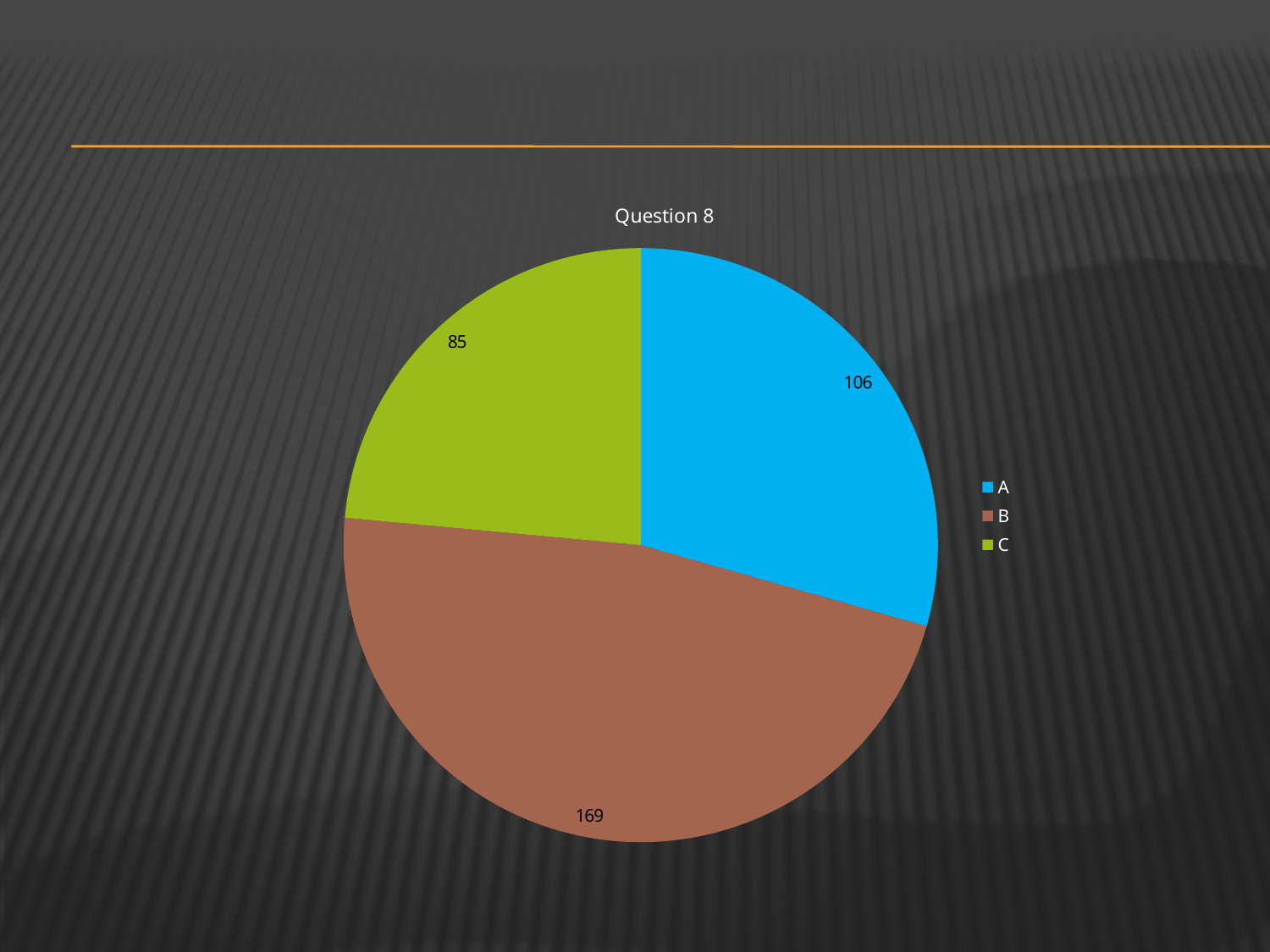
How many categories are shown in the pie chart? 3 What is the value for C in the pie chart? 85 What is the value for B in the pie chart? 169 What is the total of all the slices in the pie chart? 360 What is the value for A in the pie chart? 106 What is the difference between the values for B and A? 63 Which category has the smallest slice of the pie chart? C What is the difference between the values for A and C? 21 Which category has the largest slice of the pie chart? B What is the title of the chart? Question 8 What kind of chart is shown on the slide? Pie chart Which is larger, the value for A or the value for C? A